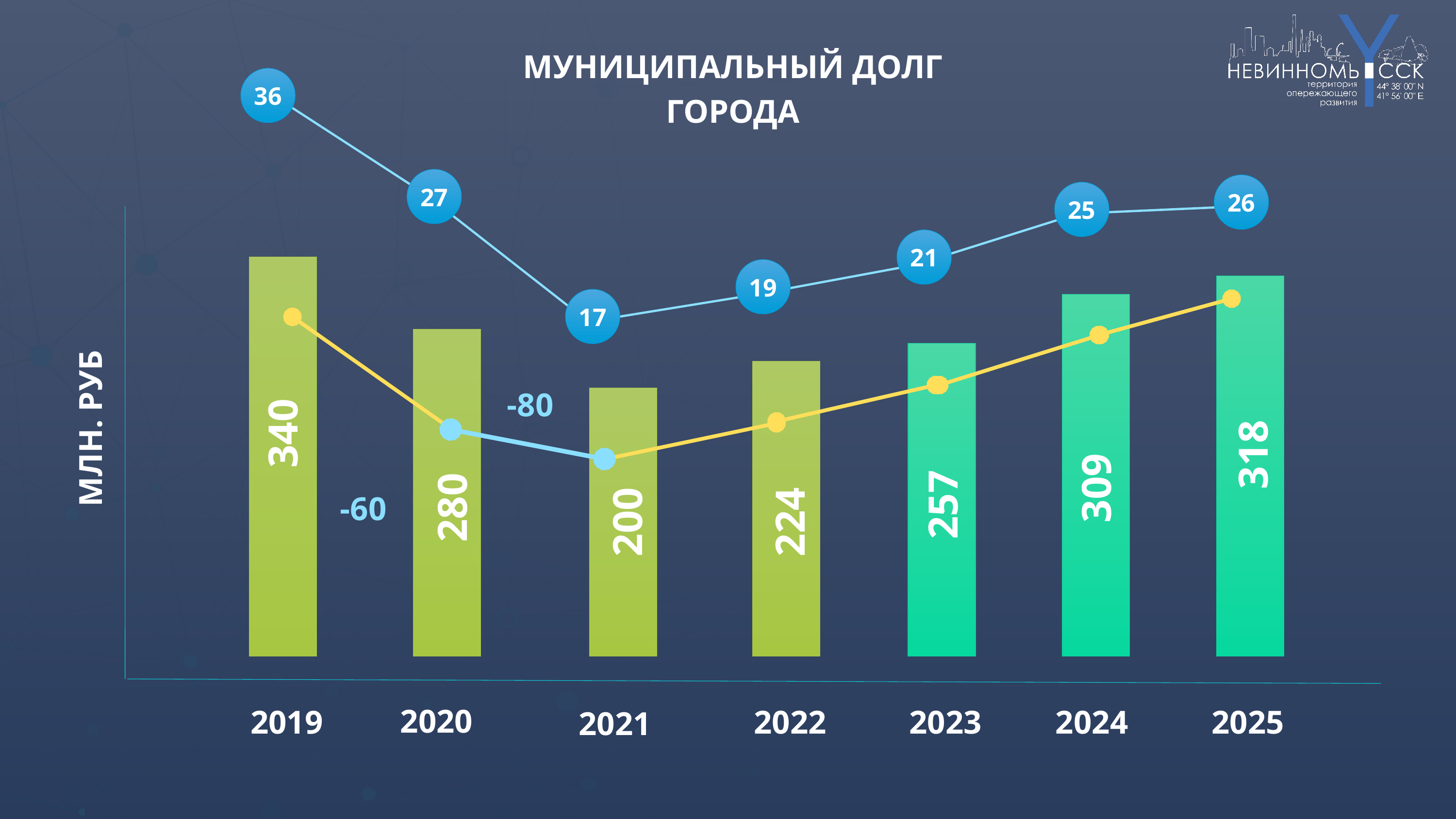
What is the difference between the municipal debt in 2025 and in 2024? 9 What is the municipal debt value shown for 2019? 340 How many years are shown on the x axis of the chart? 7 What is the title of the chart? МУНИЦИПАЛЬНЫЙ ДОЛГ ГОРОДА Which year has the highest municipal debt bar? 2019 What is the difference between the municipal debt in 2019 and in 2020? 60 Which year has the lowest municipal debt bar? 2021 What is the municipal debt value shown for 2025? 318 What value is shown in the blue circle marker above 2019? 36 What is the municipal debt value shown for 2021? 200 Which is larger, the municipal debt in 2022 or in 2023? 2023 What value is shown in the blue circle marker above 2021? 17